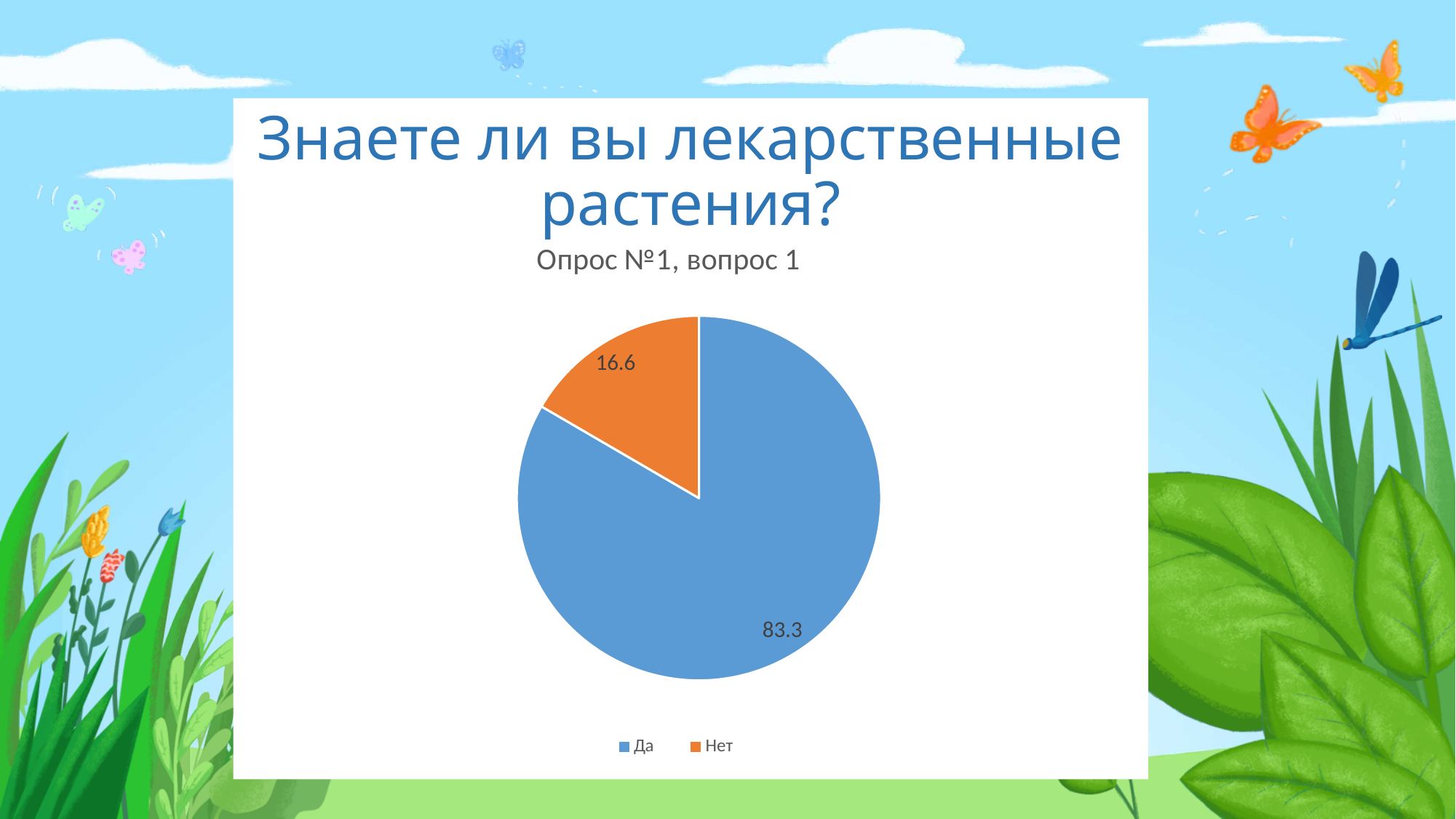
Which category has the largest slice? Да What is the title of the chart? Опрос №1, вопрос 1 What colour is the slice for "Нет"? orange What is the value for "Да"? 83.3 What kind of chart is shown on the slide? pie chart How many categories does the pie chart show? 2 How many entries does the legend list? 2 What is the value for "Нет"? 16.6 What is the difference between the values for "Да" and "Нет"? 66.7 Which category has the smallest slice? Нет Which is larger, the value for "Да" or the value for "Нет"? Да